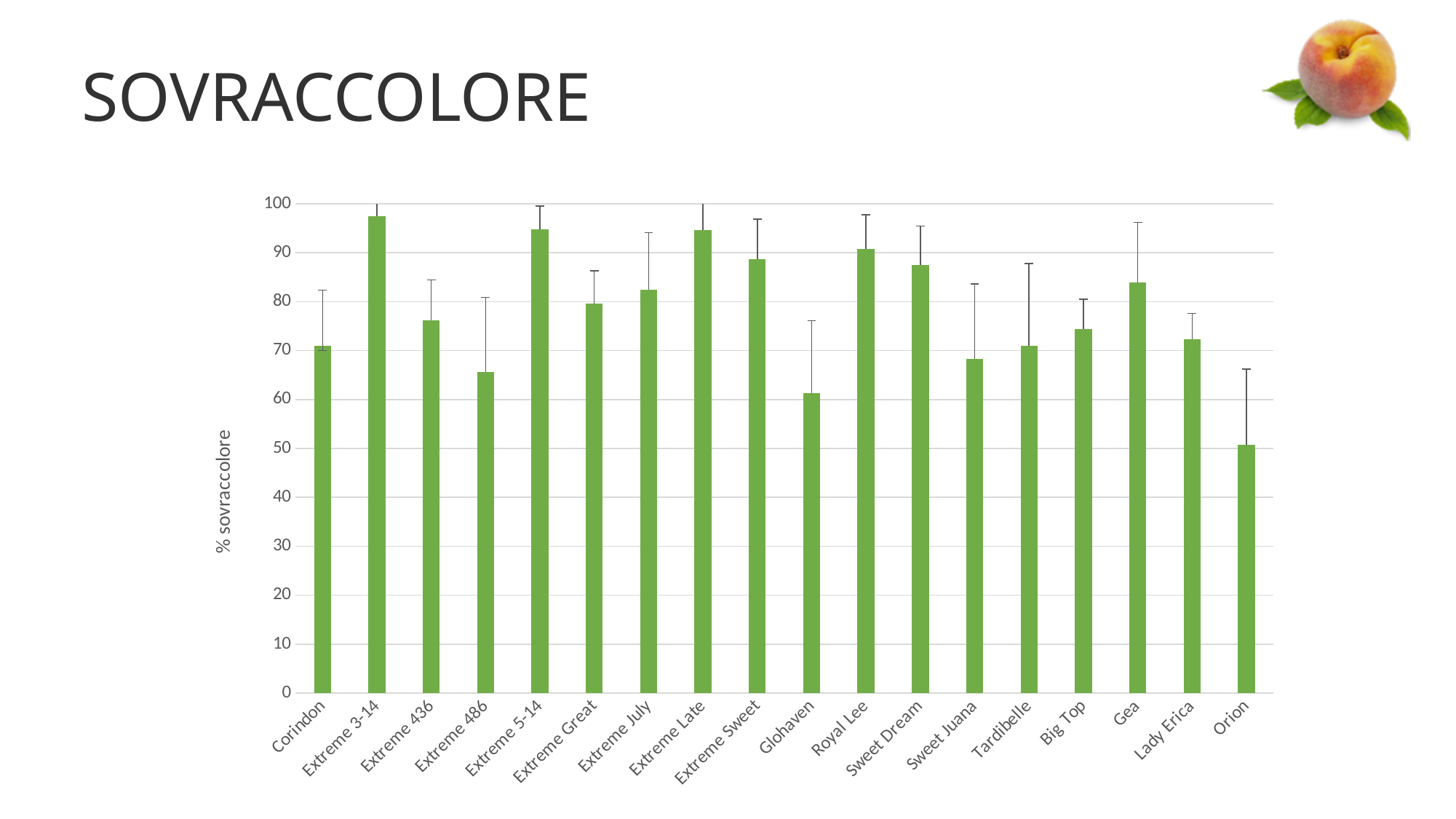
How many varieties (categories) are plotted on the x axis? 18 Which variety has the lowest % sovraccolore? Orion What is the label of the vertical axis? % sovraccolore Is the value for Gea greater or less than 80? greater Which has a higher % sovraccolore, Glohaven or Gea? Gea What kind of chart is shown on the slide? bar chart Which variety has the highest % sovraccolore? Extreme 3-14 Is the value for Extreme Sweet greater or less than 90? less Is the value for Glohaven greater or less than 70? less Which has a higher % sovraccolore, Extreme Late or Extreme July? Extreme Late